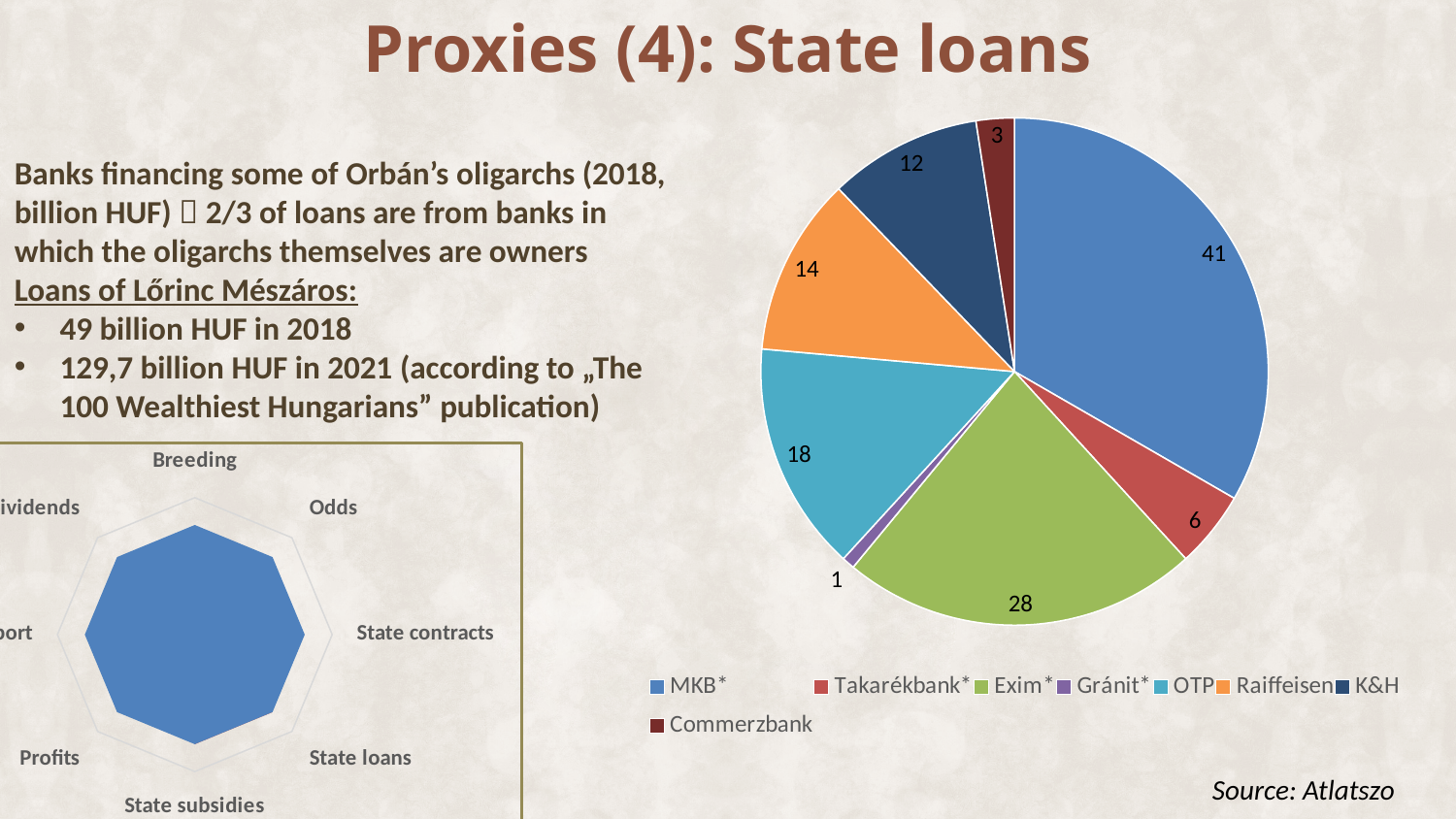
On the pie chart on the right, what is the value for OTP? 18 On the pie chart on the right, what is the value for Commerzbank? 3 On the pie chart on the right, what is the difference between the values for MKB* and Exim*? 13 What kind of chart is the chart in the lower left of the slide? Radar chart On the pie chart on the right, which is larger, the value for K&H or the value for Takarékbank*? K&H On the pie chart on the right, what is the value for MKB*? 41 What kind of chart is the chart on the right of the slide? Pie chart On the pie chart on the right, which bank has the largest slice? MKB* On the pie chart on the right, what is the value for Exim*? 28 On the pie chart on the right, what is the value for Raiffeisen? 14 How many banks does the legend of the pie chart on the right list? 8 On the pie chart on the right, which bank has the smallest slice? Gránit*